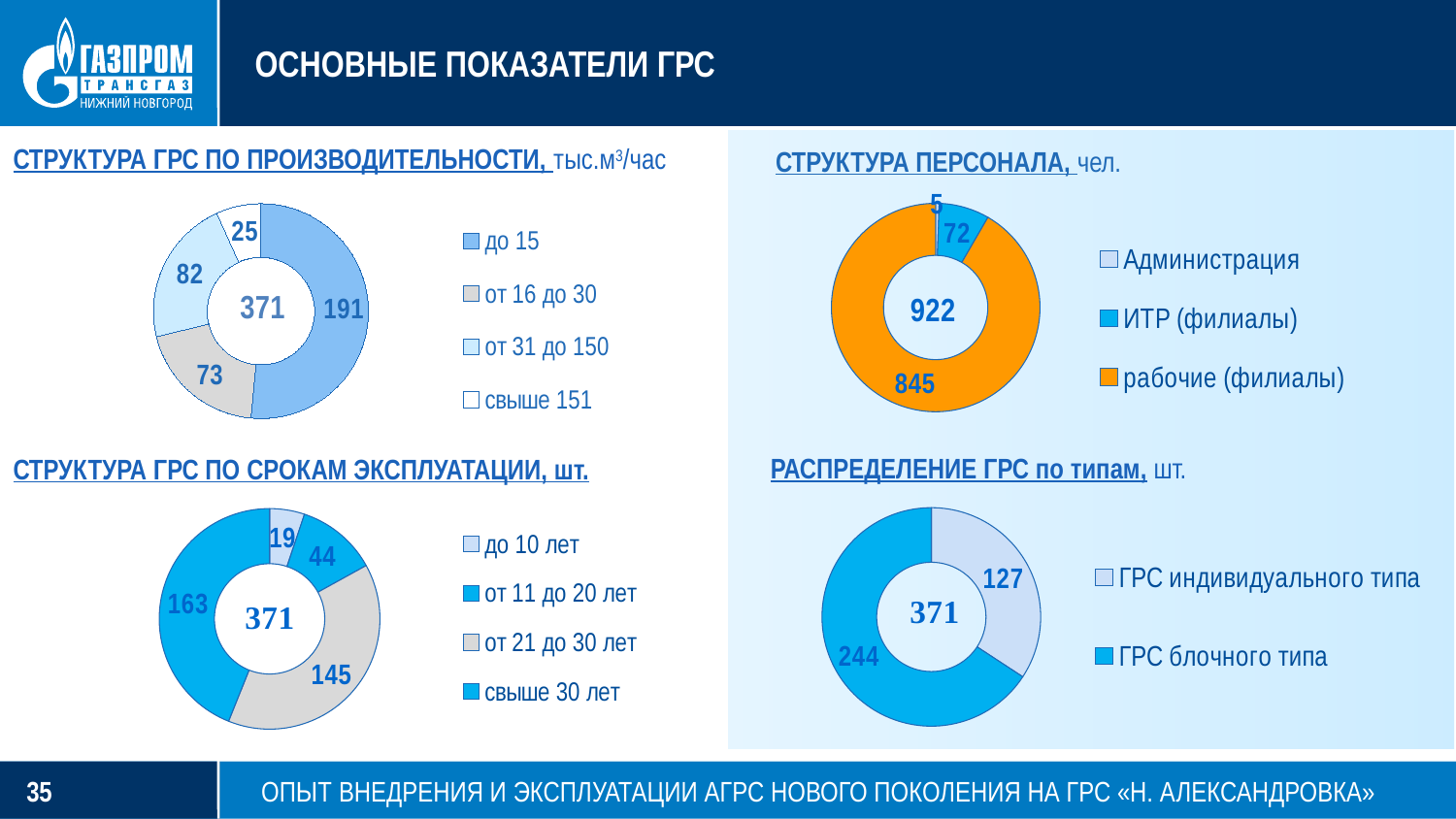
In the chart 'РАСПРЕДЕЛЕНИЕ ГРС по типам', what is the difference between 'ГРС блочного типа' and 'ГРС индивидуального типа'? 117 In the chart 'РАСПРЕДЕЛЕНИЕ ГРС по типам', what is the value for 'ГРС блочного типа'? 244 In the chart 'СТРУКТУРА ГРС ПО СРОКАМ ЭКСПЛУАТАЦИИ', which is larger: 'свыше 30 лет' or 'от 11 до 20 лет'? свыше 30 лет In the chart 'СТРУКТУРА ГРС ПО СРОКАМ ЭКСПЛУАТАЦИИ', what is the value for 'от 21 до 30 лет'? 145 What type of chart is used for 'РАСПРЕДЕЛЕНИЕ ГРС по типам'? Donut (pie) chart In the chart 'СТРУКТУРА ГРС ПО ПРОИЗВОДИТЕЛЬНОСТИ', which category has the smallest value? свыше 151 In the chart 'СТРУКТУРА ГРС ПО ПРОИЗВОДИТЕЛЬНОСТИ', what is the value for the category 'до 15'? 191 In the chart 'СТРУКТУРА ПЕРСОНАЛА', what is the value for 'ИТР (филиалы)'? 72 In the chart 'СТРУКТУРА ПЕРСОНАЛА', which category has the largest value? рабочие (филиалы) In the chart 'СТРУКТУРА ГРС ПО ПРОИЗВОДИТЕЛЬНОСТИ', what is the difference between the values for 'от 31 до 150' and 'от 16 до 30'? 9 In the chart 'СТРУКТУРА ПЕРСОНАЛА', what is the total number shown in the centre of the donut? 922 How many categories does the legend of the chart 'СТРУКТУРА ГРС ПО СРОКАМ ЭКСПЛУАТАЦИИ' list? 4